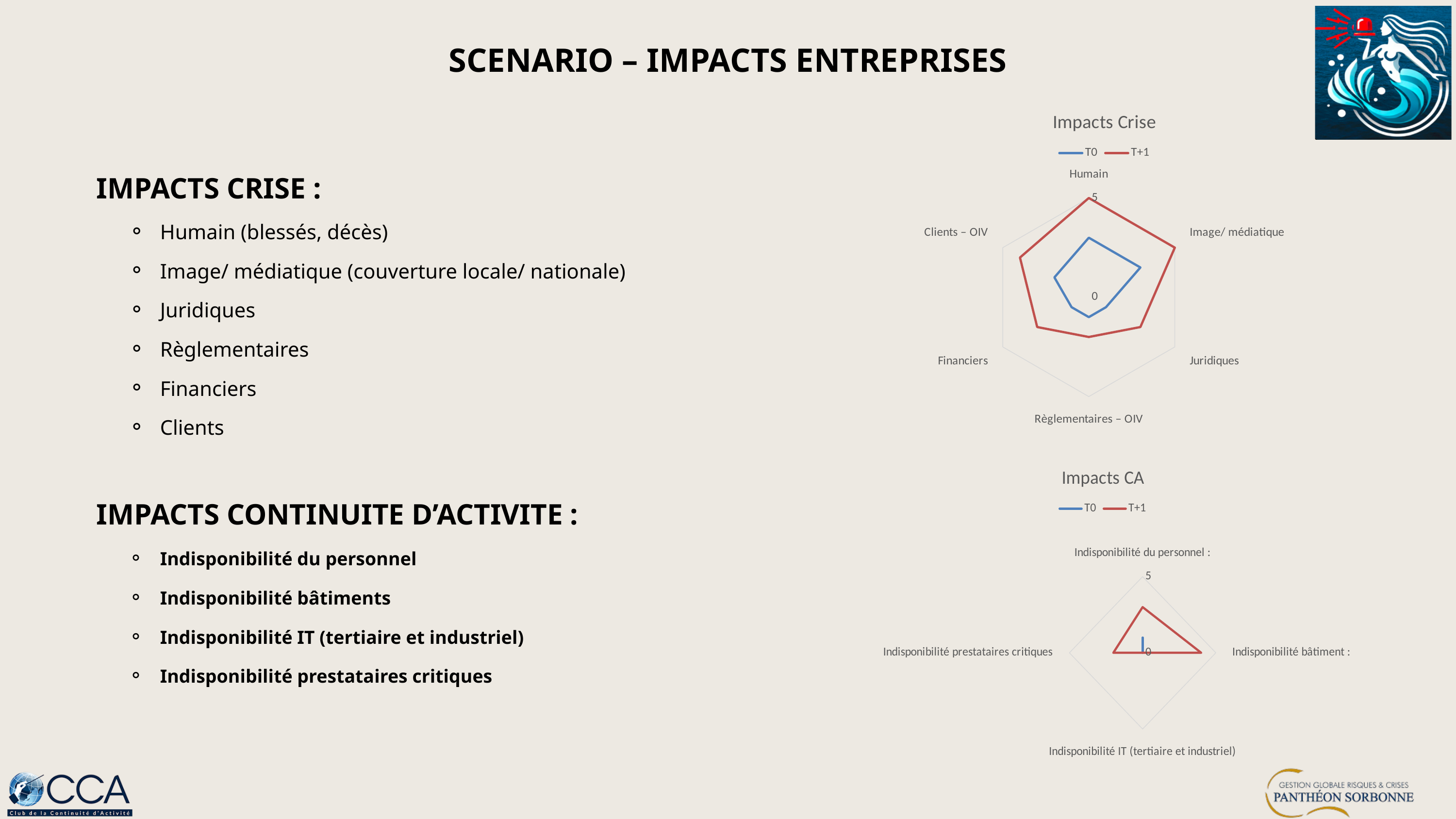
In the 'Impacts CA' chart, which series has the larger value for 'Indisponibilité bâtiment', T0 or T+1? T+1 How many series does the legend of the 'Impacts Crise' chart list? 2 What are the two series names in the legend of the 'Impacts CA' chart? T0 and T+1 What kind of chart is the 'Impacts Crise' chart? Radar chart In the 'Impacts CA' chart, is the T+1 value for 'Indisponibilité du personnel' greater or less than 5? less In the 'Impacts Crise' chart, which series has the larger value for Humain, T0 or T+1? T+1 How many categories (axes) does the 'Impacts CA' chart have? 4 In the 'Impacts Crise' chart, is the T0 value for Humain greater or less than 5? less In the 'Impacts Crise' chart, what colour is the T+1 series line? Red What kind of chart is the 'Impacts CA' chart? Radar chart How many categories (axes) does the 'Impacts Crise' chart have? 6